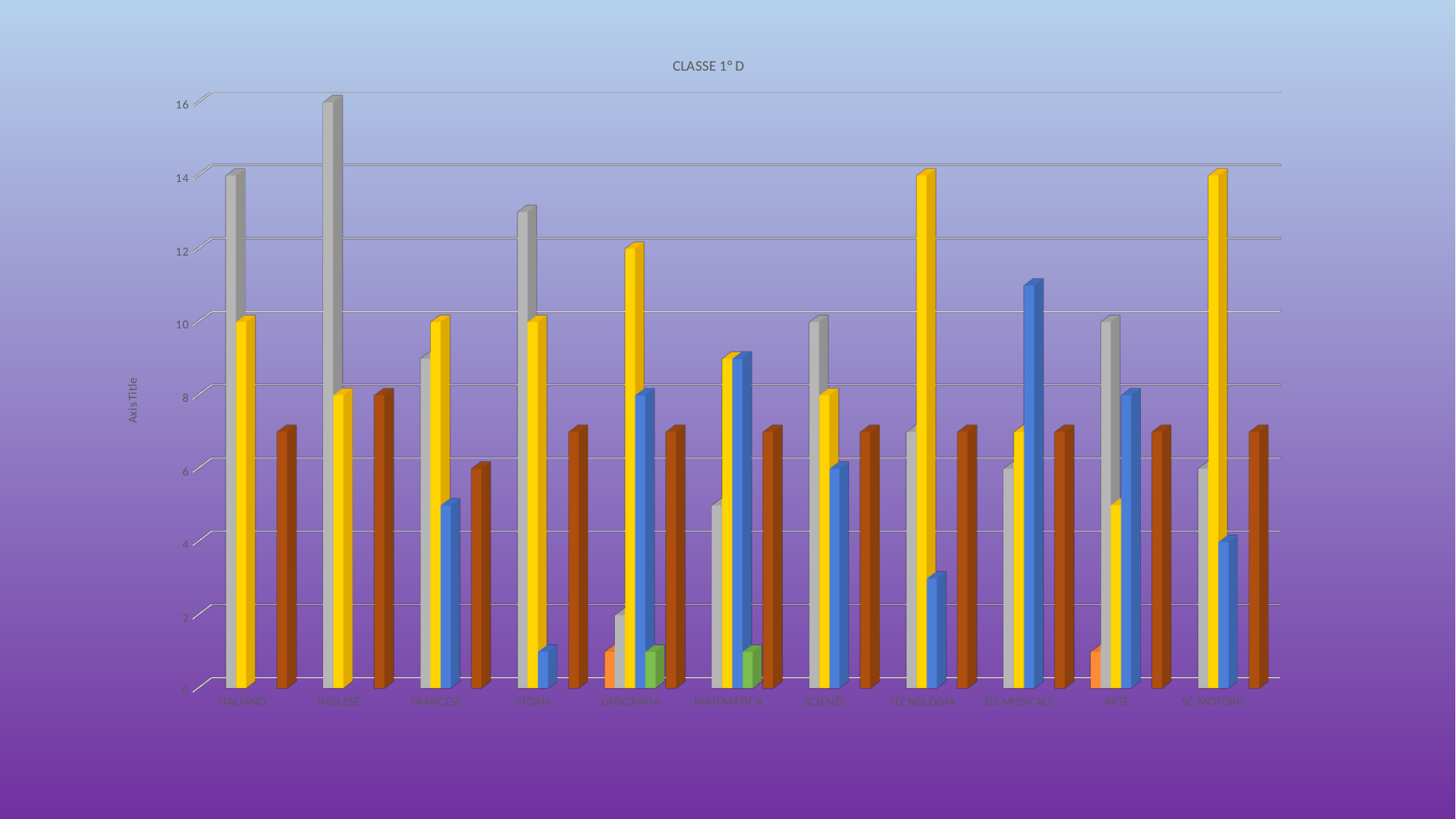
Is the blue bar for STORIA greater or less than 2? less What kind of chart is shown on the slide? bar chart Is the gray bar for INGLESE greater or less than 14? greater Is the blue bar for ED.MUSICALE greater or less than 10? greater How many categories are shown along the x axis of the chart? 11 Which category has the shortest blue bar? STORIA Which category has the tallest bar in the whole chart? INGLESE Which category has the tallest blue bar? ED.MUSICALE What is the title of the chart? CLASSE 1° D Which is taller, the gray bar for ITALIANO or the gray bar for FRANCESE? ITALIANO